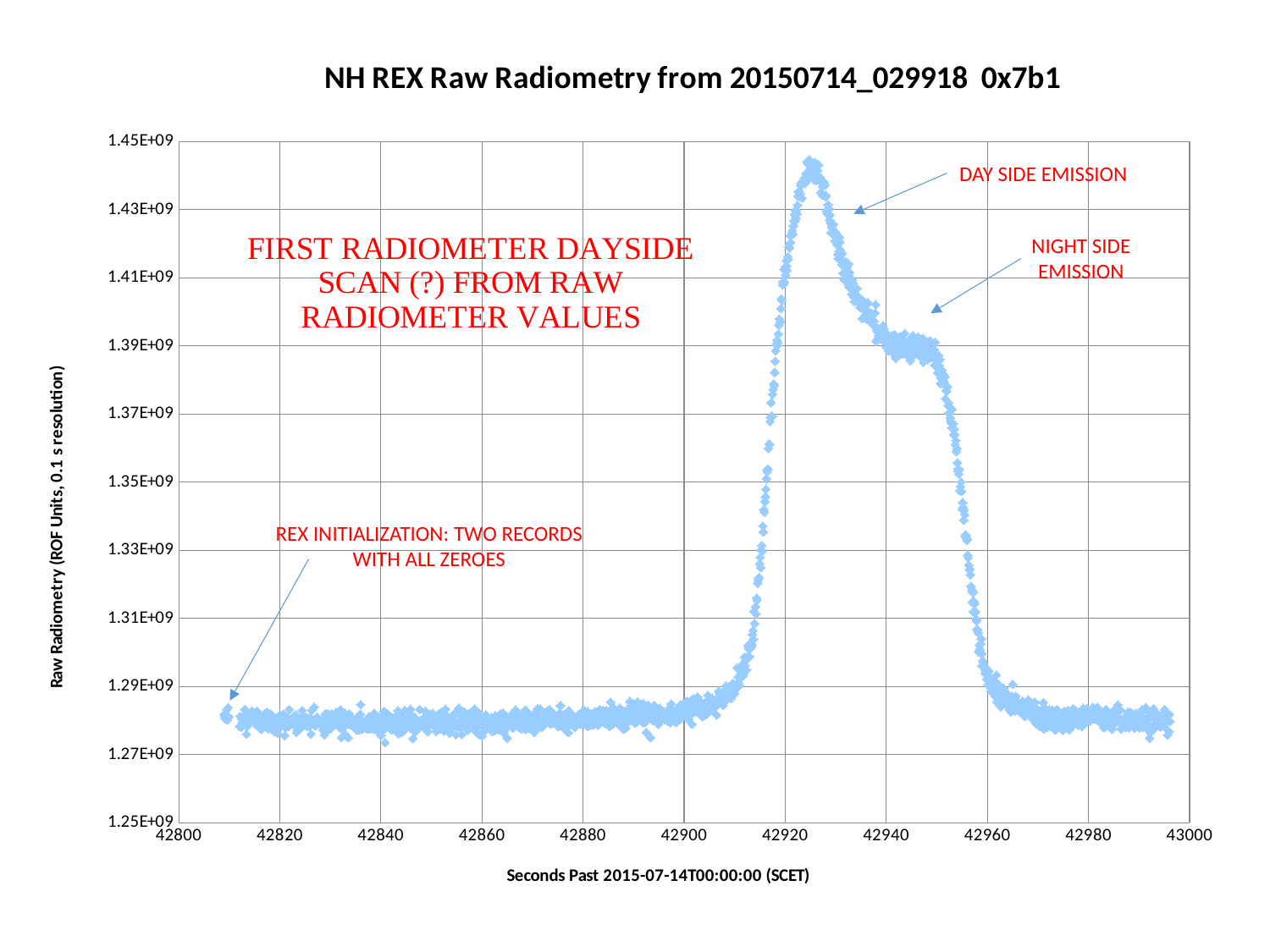
What kind of chart is shown on the slide? scatter chart Is the peak value of the plotted data, near x = 42925, greater or less than 1.43E+09? greater Which is larger: the value at x = 42920 or the value at x = 42860? the value at x = 42920 Which is larger: the value at the DAY SIDE EMISSION peak or the value at the NIGHT SIDE EMISSION plateau? the DAY SIDE EMISSION peak Between which two x-axis ticks does the maximum plotted value occur? between 42920 and 42940 Which annotation labels the highest peak of the plotted data? DAY SIDE EMISSION Is the value at x = 42860 greater or less than 1.29E+09? less Is the value at x = 42945 greater or less than 1.37E+09? greater Do the plotted values rise or fall as x increases from 42950 to 42960? fall What is the title of the chart? NH REX Raw Radiometry from 20150714_029918 0x7b1 Do the plotted values rise or fall as x increases from 42900 to 42925? rise